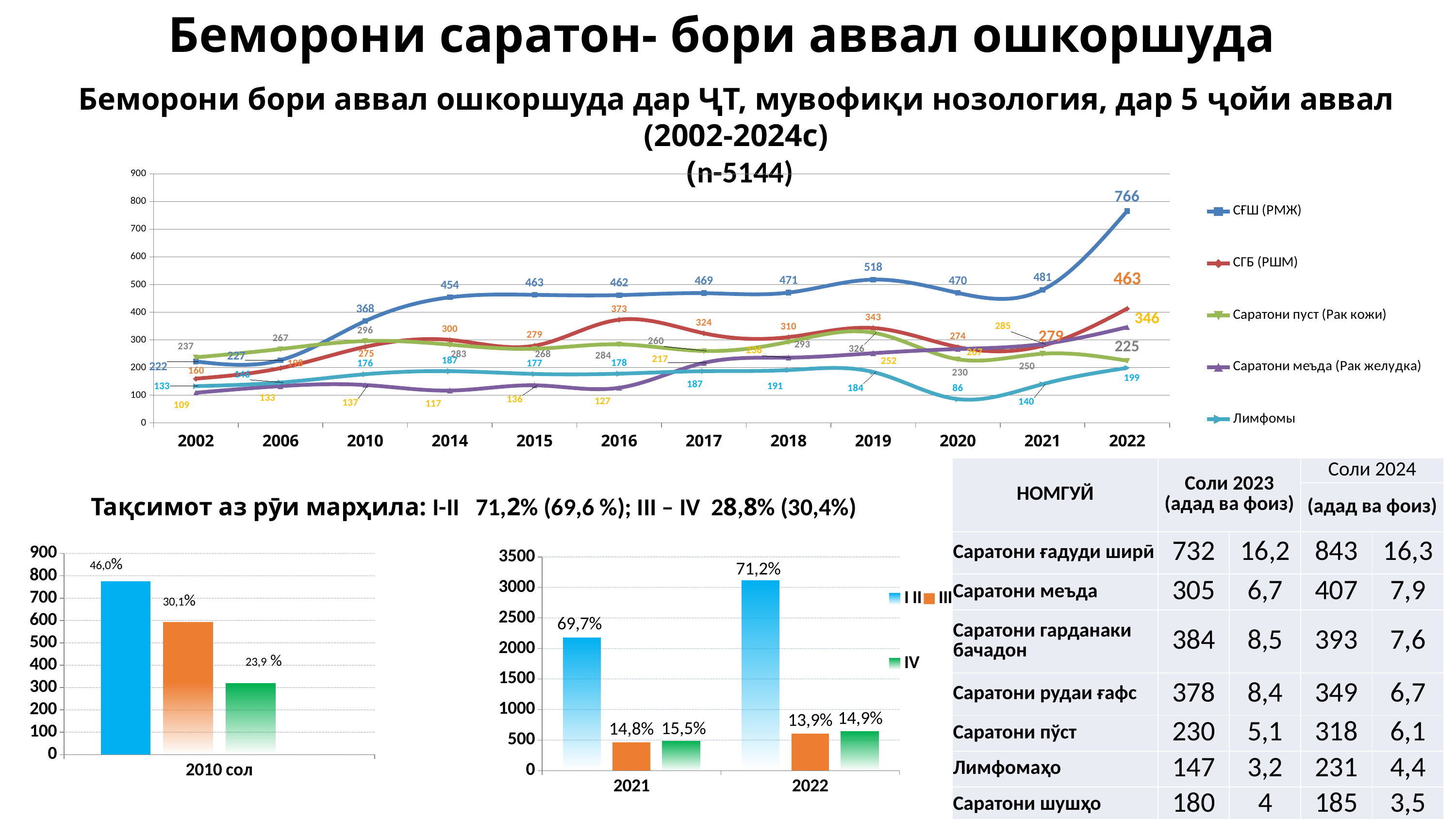
In the bottom-middle bar chart, which year has the larger IV value, 2021 or 2022? 2022 In the top line chart, what is the difference between the СҒШ (РМЖ) and СГБ (РШМ) values in 2022? 303 In the bottom-middle bar chart, what is the value of the I-II series in 2022? 71,2% In the bottom-middle bar chart, is the I-II bar for 2021 greater or less than 2000? greater In the top line chart, what is the value of the СГБ (РШМ) series in 2022? 463 In the top line chart, what is the value of the Лимфомы series in 2020? 86 How many series does the legend of the top line chart list? 5 In the top line chart, in which year does the СҒШ (РМЖ) series reach its highest value? 2022 In the bottom-left bar chart labelled 2010 сол, what percentage is shown above the tallest bar? 46,0% What kind of chart is the top chart on the slide? line chart In the top line chart, what is the value of the СҒШ (РМЖ) series in 2022? 766 How many years are plotted on the x axis of the top line chart? 12